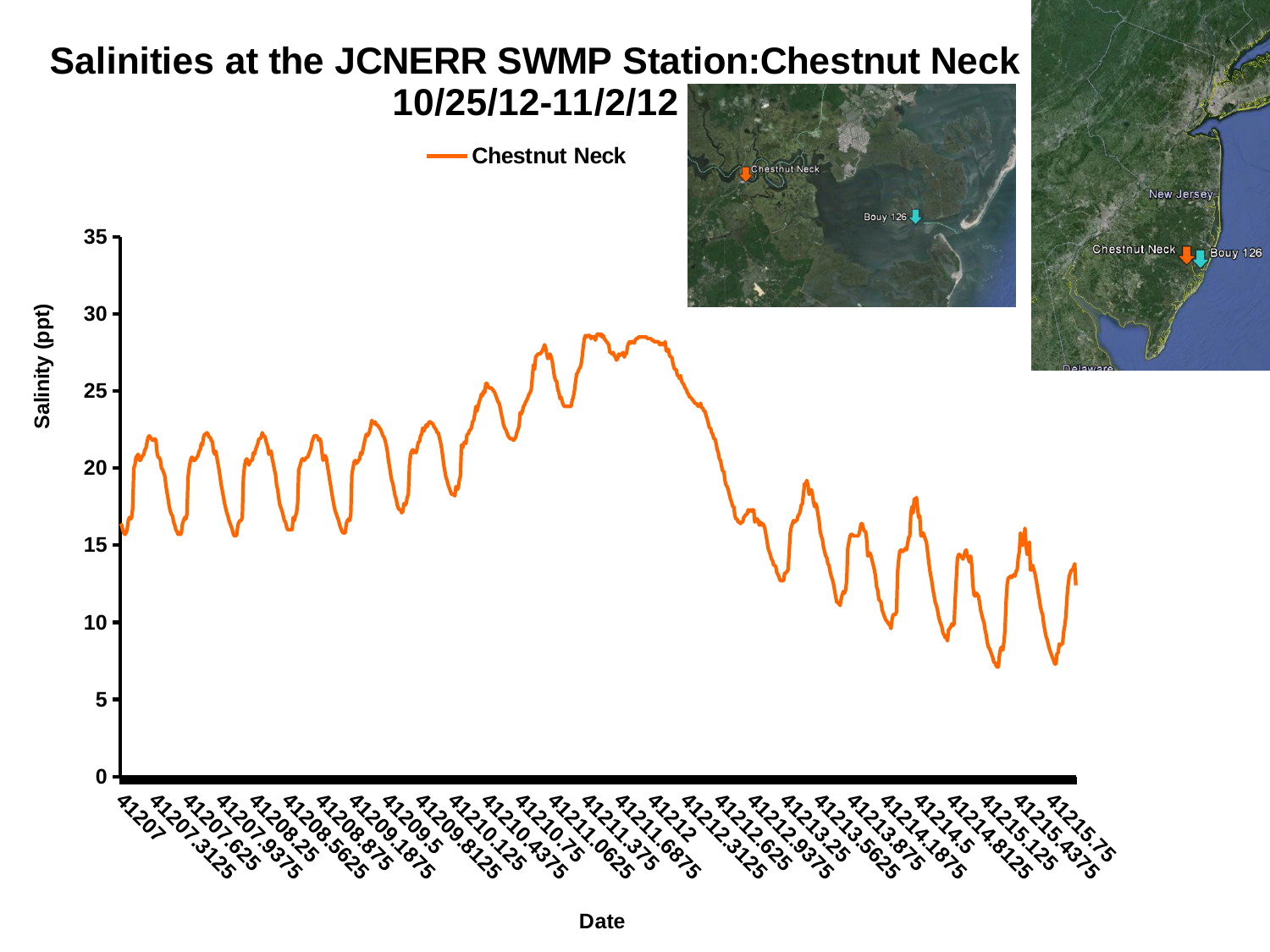
Is the salinity value at the date 41207 greater or less than 20? less What is the label on the chart's vertical axis? Salinity (ppt) Is the lowest salinity value reached on the chart greater or less than 10? less How many series does the chart's legend list? 1 What kind of chart is shown on the slide? line chart Is the salinity at the end of the period (41215.75) higher or lower than at the start (41207)? lower Is the salinity value at the date 41212 greater or less than 25? greater What is the highest value shown on the chart's vertical axis? 35 Is the salinity around the date 41211.375 higher or lower than around the date 41213.875? higher What is the name of the series shown in the chart's legend? Chestnut Neck